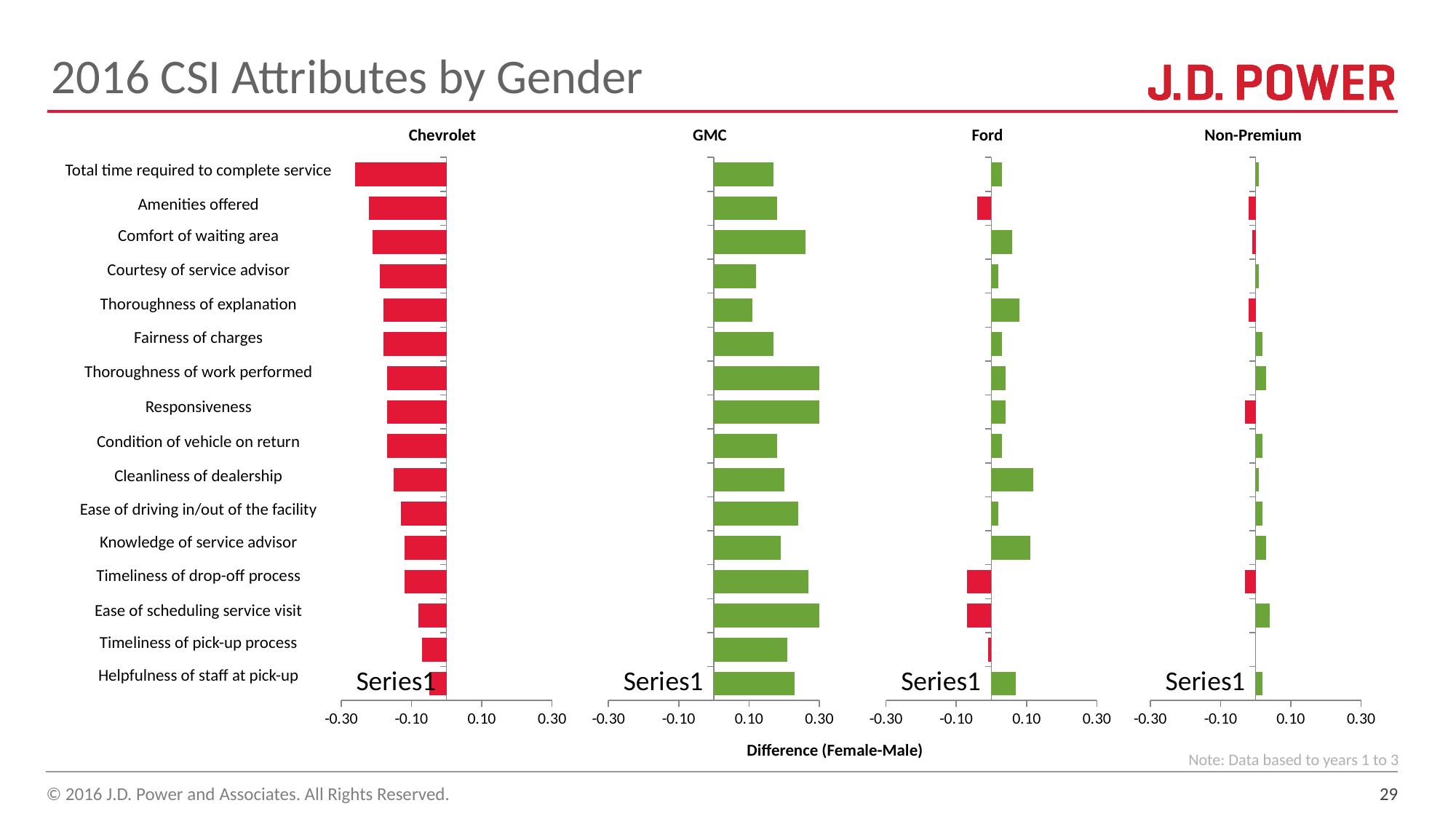
In the GMC chart, is the value for Comfort of waiting area greater or less than 0.10? greater How many attribute categories are listed on the y axis of the charts? 16 In the Chevrolet chart, which attribute has the lowest (most negative) value? Total time required to complete service What kind of chart is used for the Chevrolet panel? Bar chart In the Chevrolet chart, which attribute has the highest value (closest to zero)? Helpfulness of staff at pick-up What is the title of the shared x axis beneath the charts? Difference (Female-Male) In the GMC chart, which is larger: the value for Comfort of waiting area or the value for Courtesy of service advisor? Comfort of waiting area How many separate bar charts are shown on the slide? 4 In the Ford chart, how many attributes have a negative (red) bar? 4 In the Ford chart, is the value for Timeliness of drop-off process greater or less than -0.10? greater In the Chevrolet chart, is the value for Total time required to complete service greater or less than -0.10? less